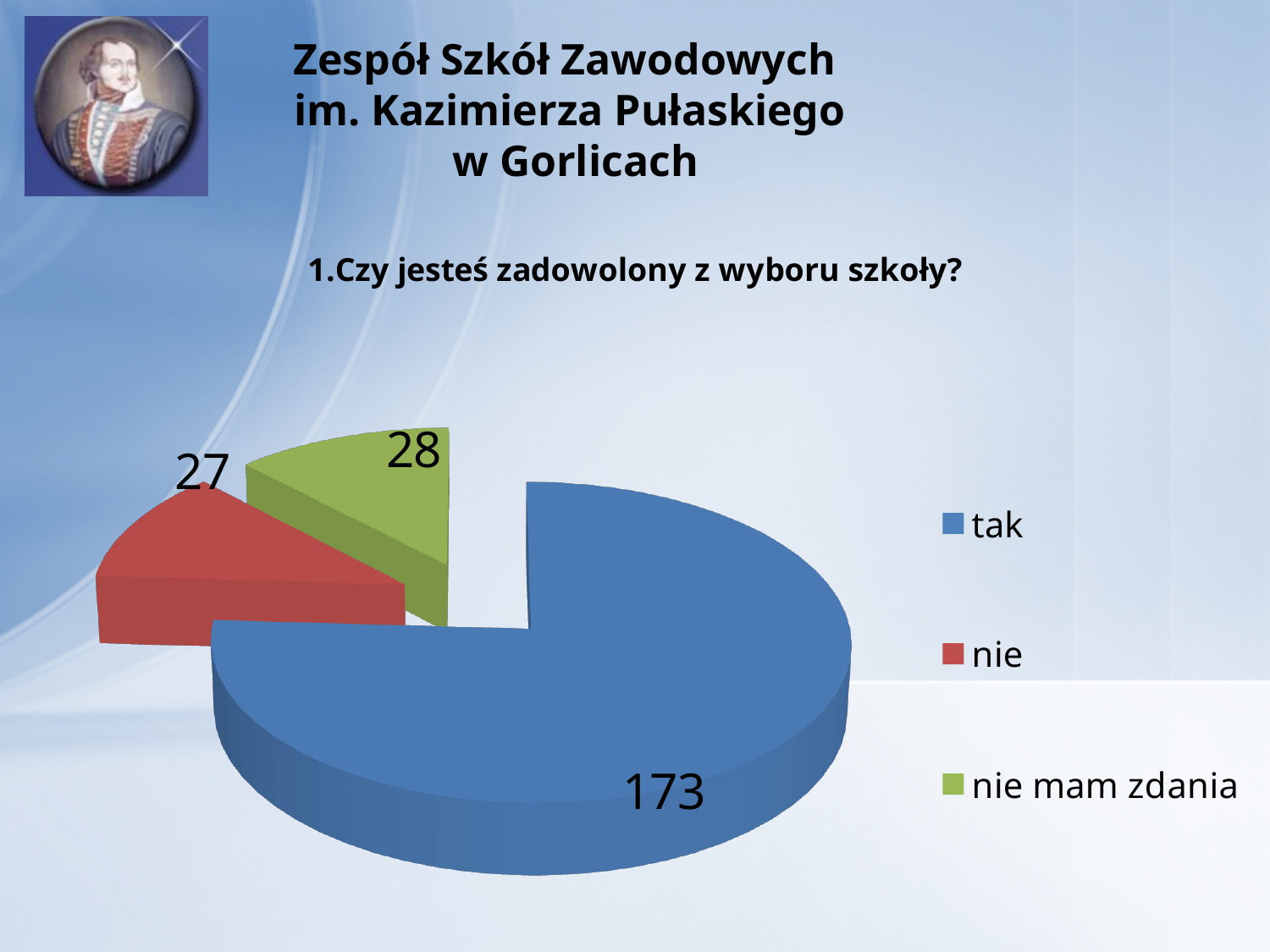
What is the difference between the number of "tak" responses and the number of "nie" responses? 146 What is the difference between the values for "nie mam zdania" and "nie"? 1 How many responses are shown for "nie mam zdania"? 28 How many responses are shown for "nie"? 27 How many responses are shown for "tak"? 173 What is the total of all three values shown on the pie chart? 228 Which has a larger value, "nie" or "nie mam zdania"? nie mam zdania How many categories does the pie chart have? 3 Which answer category has the smallest value? nie What kind of chart is shown on the slide? pie chart What colour is the slice for "nie mam zdania"? green Which answer category has the largest slice of the pie? tak